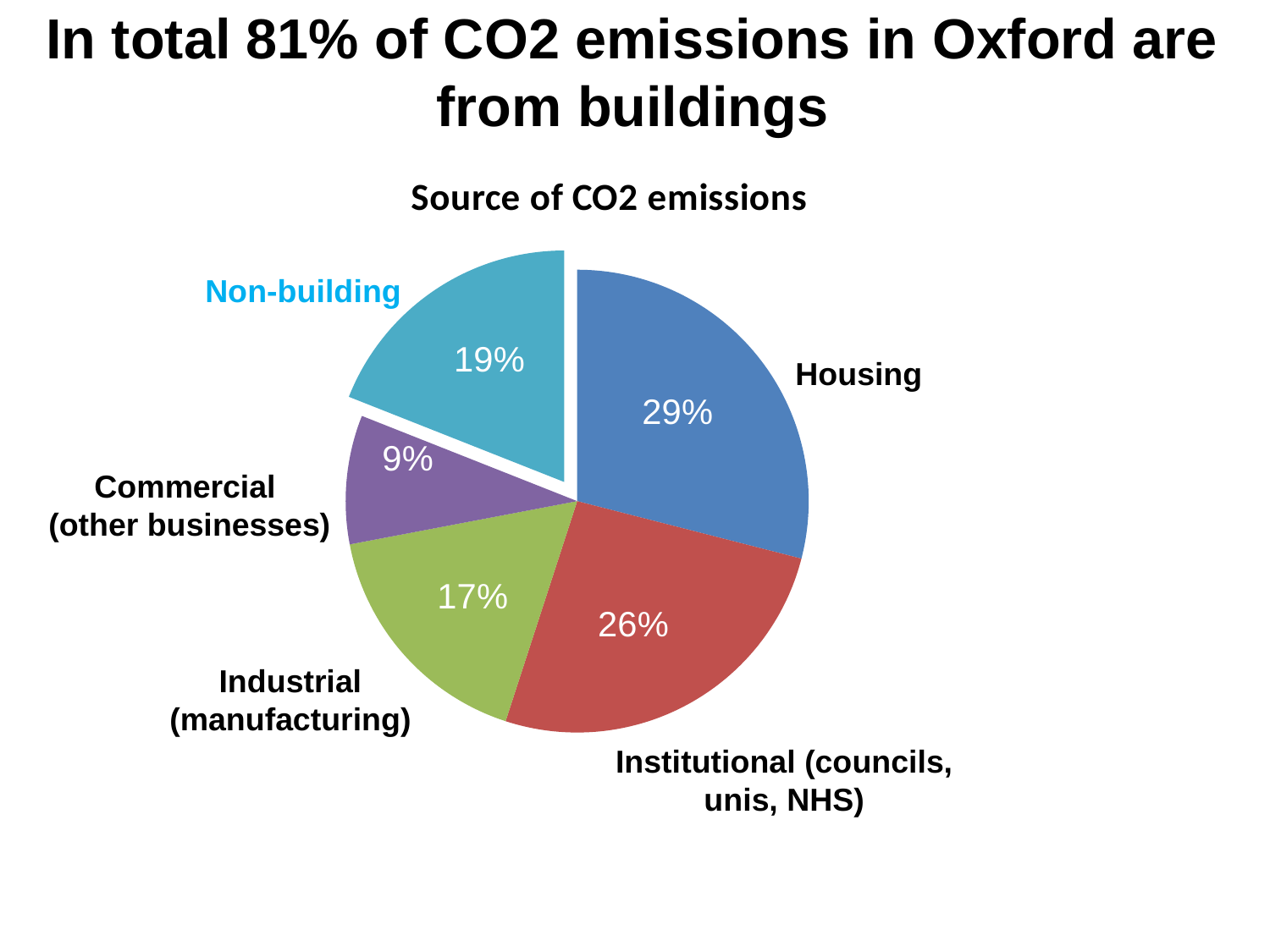
Which source accounts for the largest share of CO2 emissions? Housing What is the difference between the Housing share and the Institutional share? 3% What share of CO2 emissions comes from Industrial (manufacturing)? 17% What share of CO2 emissions comes from Non-building sources? 19% Which is larger, the Non-building share or the Industrial (manufacturing) share? Non-building What share of CO2 emissions comes from Institutional (councils, unis, NHS)? 26% What kind of chart is shown on the slide? Pie chart What share of CO2 emissions comes from Housing? 29% Which source accounts for the smallest share of CO2 emissions? Commercial (other businesses) How many slices does the pie chart have? 5 What is the chart's title? Source of CO2 emissions What share of CO2 emissions comes from Commercial (other businesses)? 9%